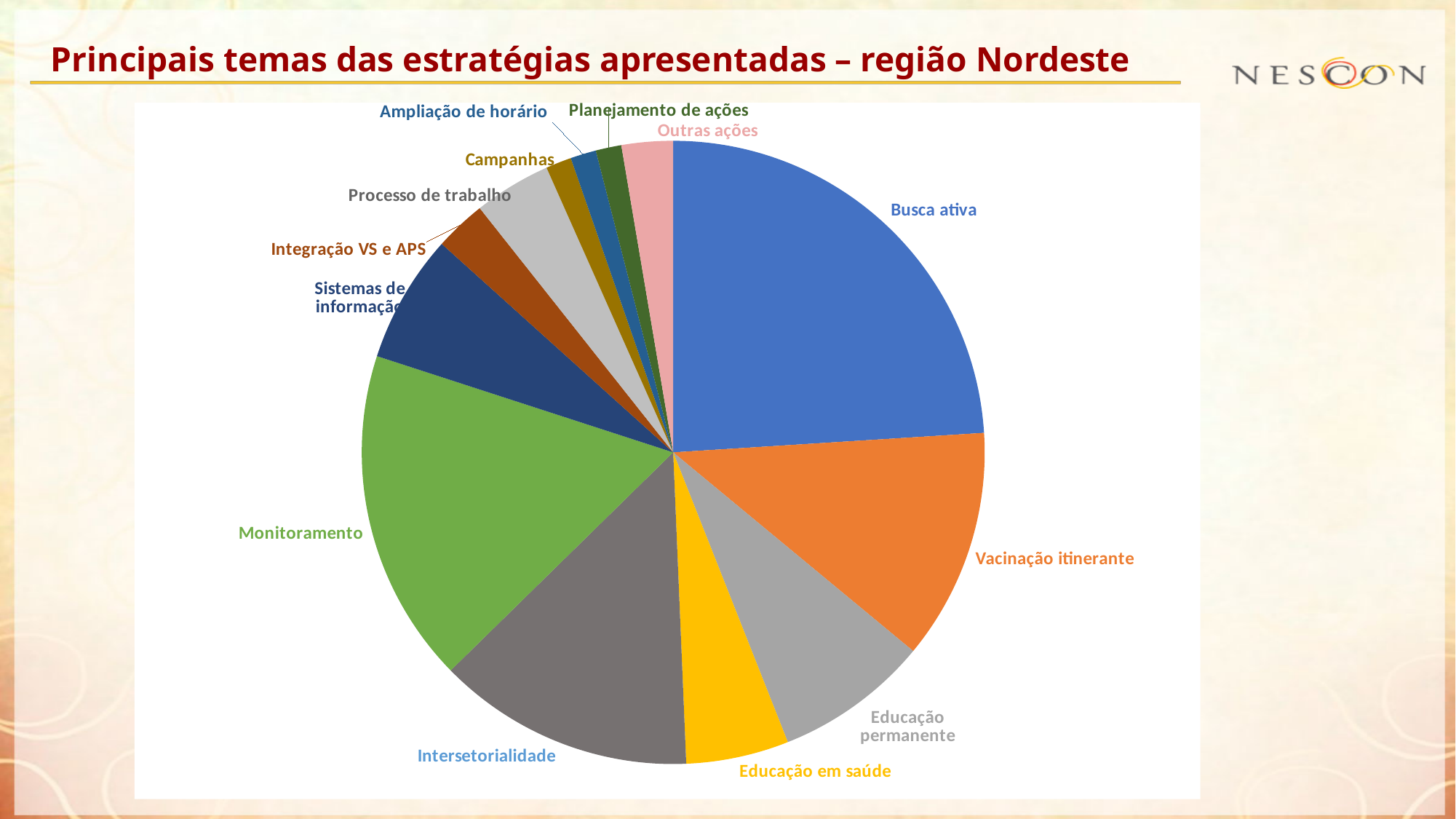
How many categories (slices) does the pie chart have? 13 Which category has the largest slice of the pie chart? Busca ativa What is the title of the slide containing the pie chart? Principais temas das estratégias apresentadas – região Nordeste What colour is the Busca ativa slice in the pie chart? blue What kind of chart is shown on the slide? pie chart Which slice is larger, Monitoramento or Intersetorialidade? Monitoramento Which slice is larger, Educação permanente or Educação em saúde? Educação permanente Which slice is larger, Vacinação itinerante or Sistemas de informação? Vacinação itinerante